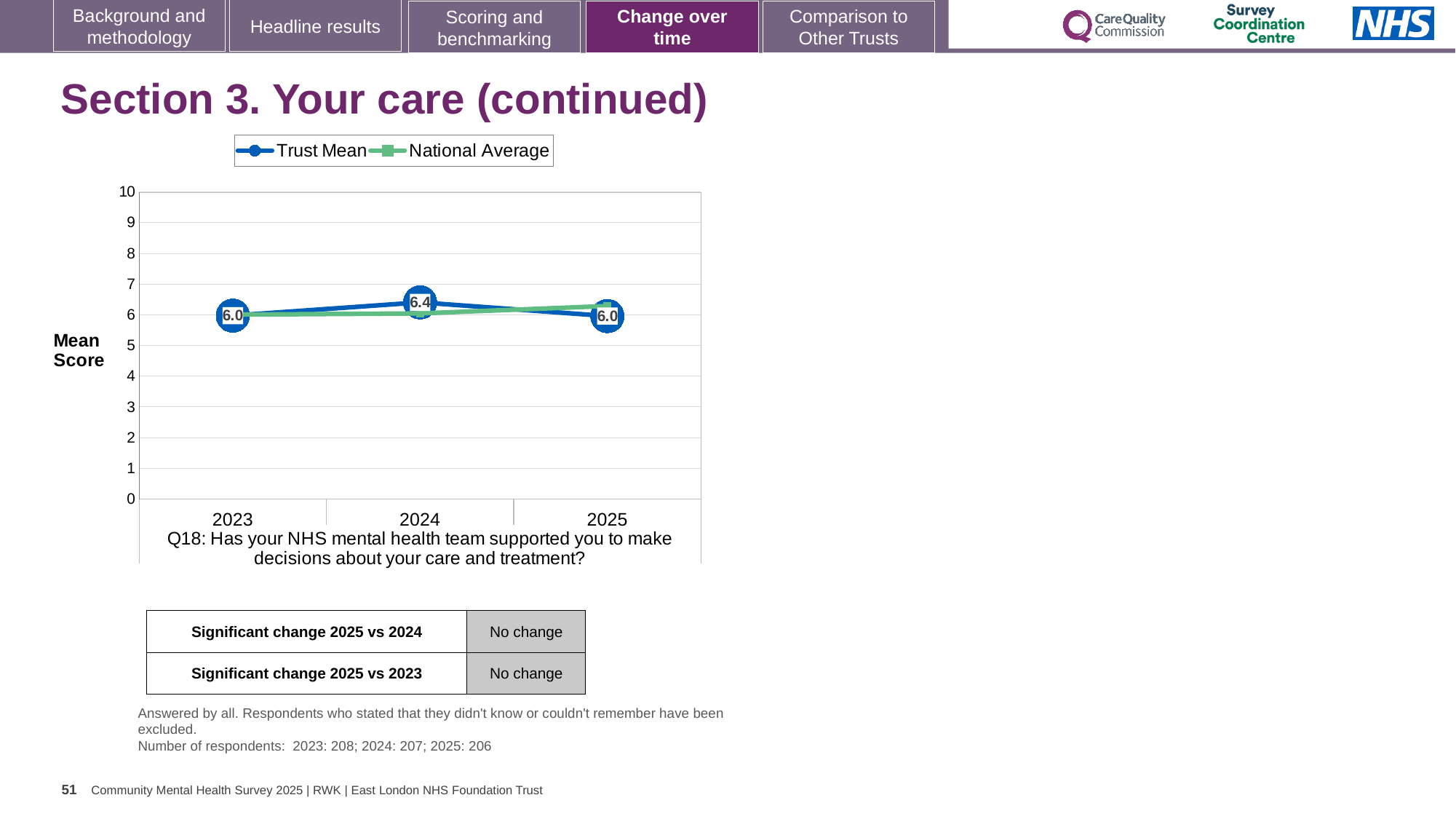
What is the Trust Mean value for 2023? 6.0 How many years are plotted on the x axis? 3 What is the Trust Mean value for 2024? 6.4 What is the difference between the Trust Mean in 2024 and in 2023? 0.4 What kind of chart is shown on the slide? Line chart How many series does the legend list? 2 Which is larger, the Trust Mean for 2024 or for 2025? 2024 In which year is the Trust Mean highest? 2024 Is the National Average value for 2025 greater or less than 7? less What is the Trust Mean value for 2025? 6.0 Does the Trust Mean rise or fall from 2024 to 2025? Fall What is the label on the y axis of the chart? Mean Score